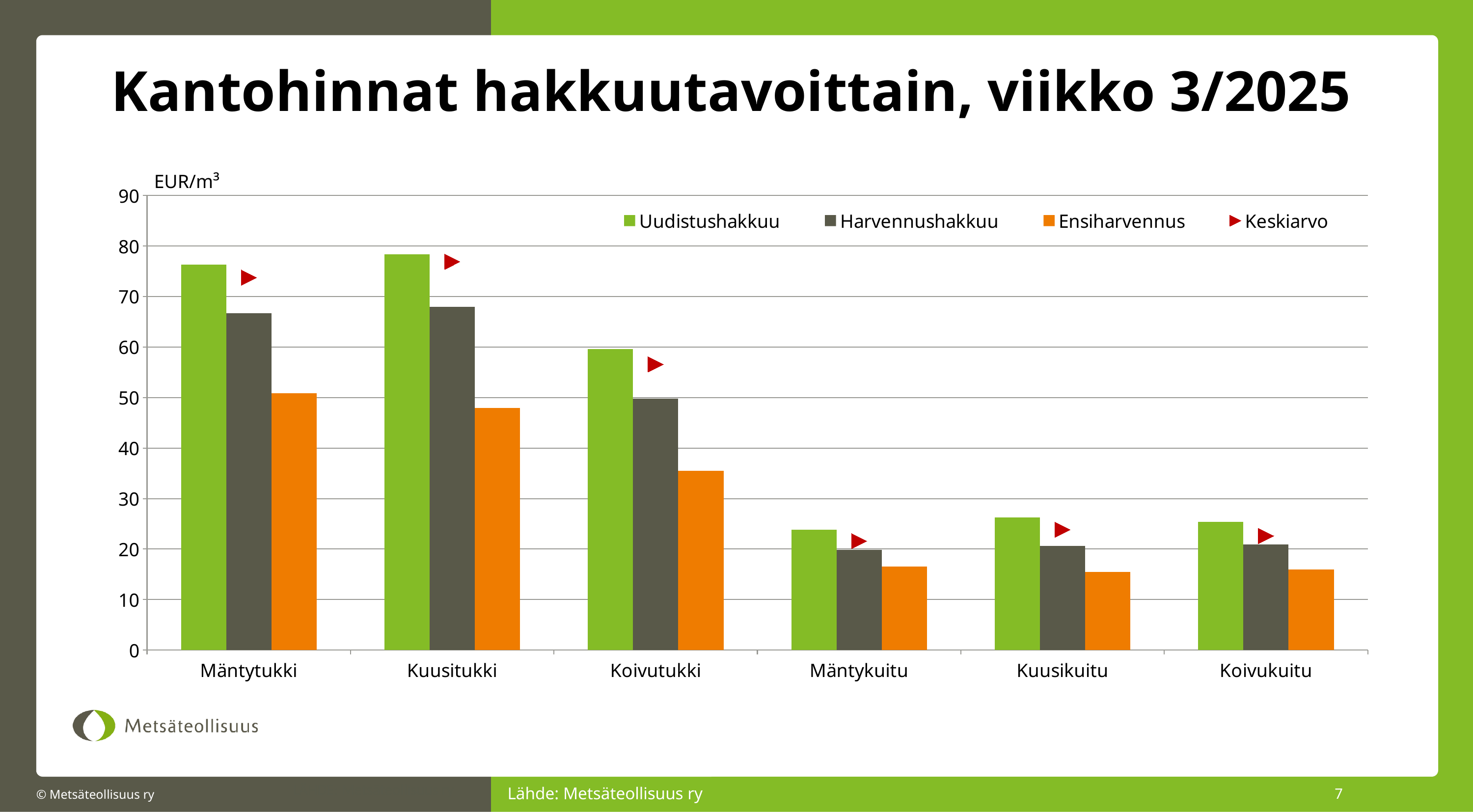
How many categories are shown on the x axis of the chart? 6 What unit is shown on the chart's value axis? EUR/m³ Which legend entry is shown with a red triangle marker? Keskiarvo Is the Uudistushakkuu value for Mäntykuitu greater or less than 20? greater Is the Uudistushakkuu value for Mäntytukki greater or less than 70? greater How many series does the chart's legend list? 4 Which category has the highest Uudistushakkuu value? Kuusitukki Which is larger: the Harvennushakkuu value for Mäntytukki or for Koivutukki? Mäntytukki Is the Ensiharvennus value for Kuusikuitu greater or less than 20? less What kind of chart is shown on the slide? bar chart